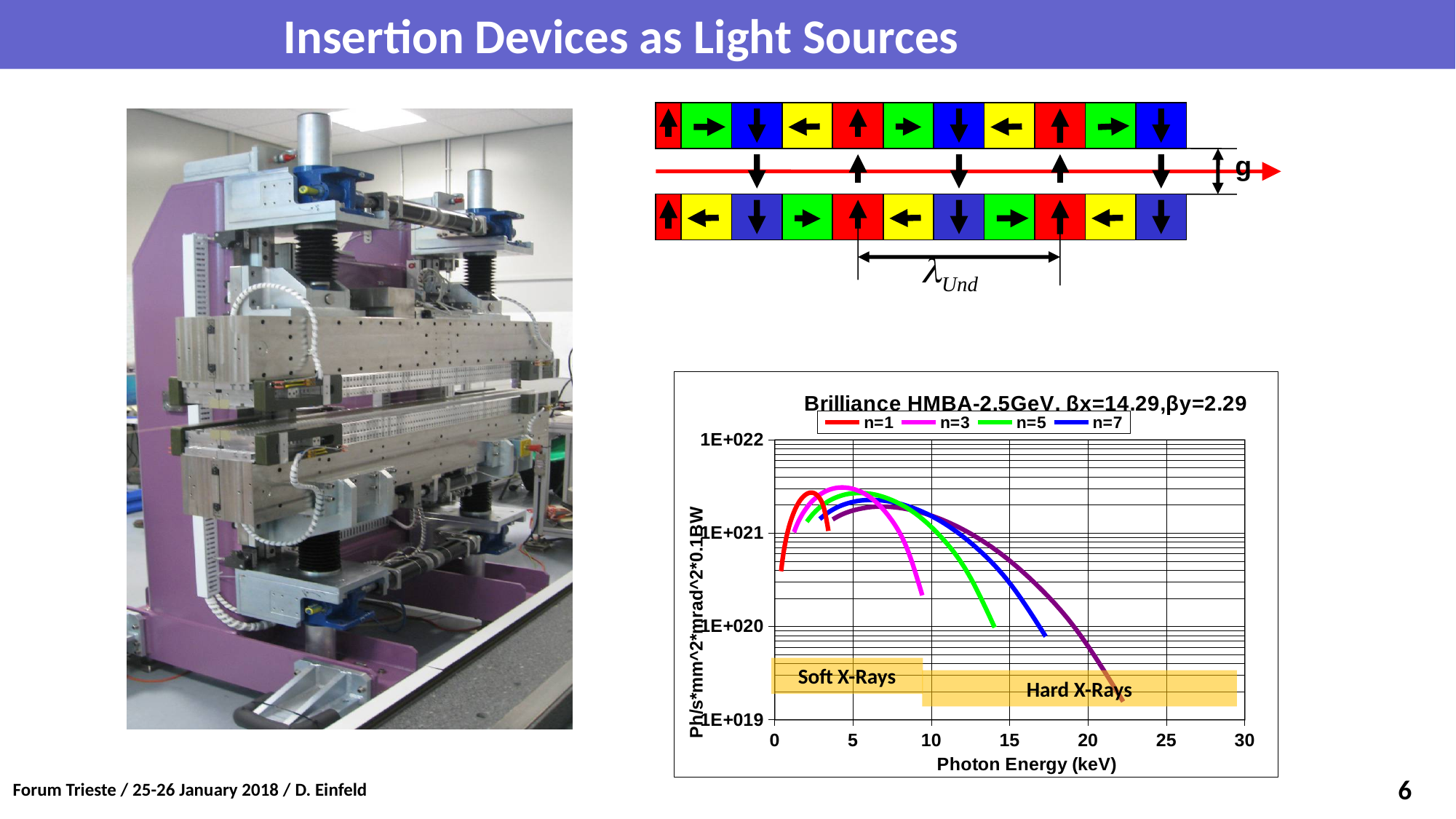
How many series does the legend of the brilliance chart list? 4 Do the brilliance curves rise or fall as photon energy increases beyond 10 keV? Fall Which legend series ends at the lowest photon energy? n=1 What is the highest value shown on the y axis of the brilliance chart? 1E+022 What is the label of the x axis of the brilliance chart? Photon Energy (keV) Which legend series reaches its peak at a higher photon energy, n=1 or n=3? n=3 Is the value of the n=7 curve at 15 keV greater or less than 1E+020? greater Among the series listed in the legend, which extends to the highest photon energy? n=7 What is the title of the chart on the slide? Brilliance HMBA-2.5GeV, ßx=14.29,βy=2.29 Is the value of the n=3 curve at 9 keV greater or less than 1E+021? less Is the peak value of the n=1 curve greater or less than 1E+021? greater What kind of chart is shown on the slide? Line chart